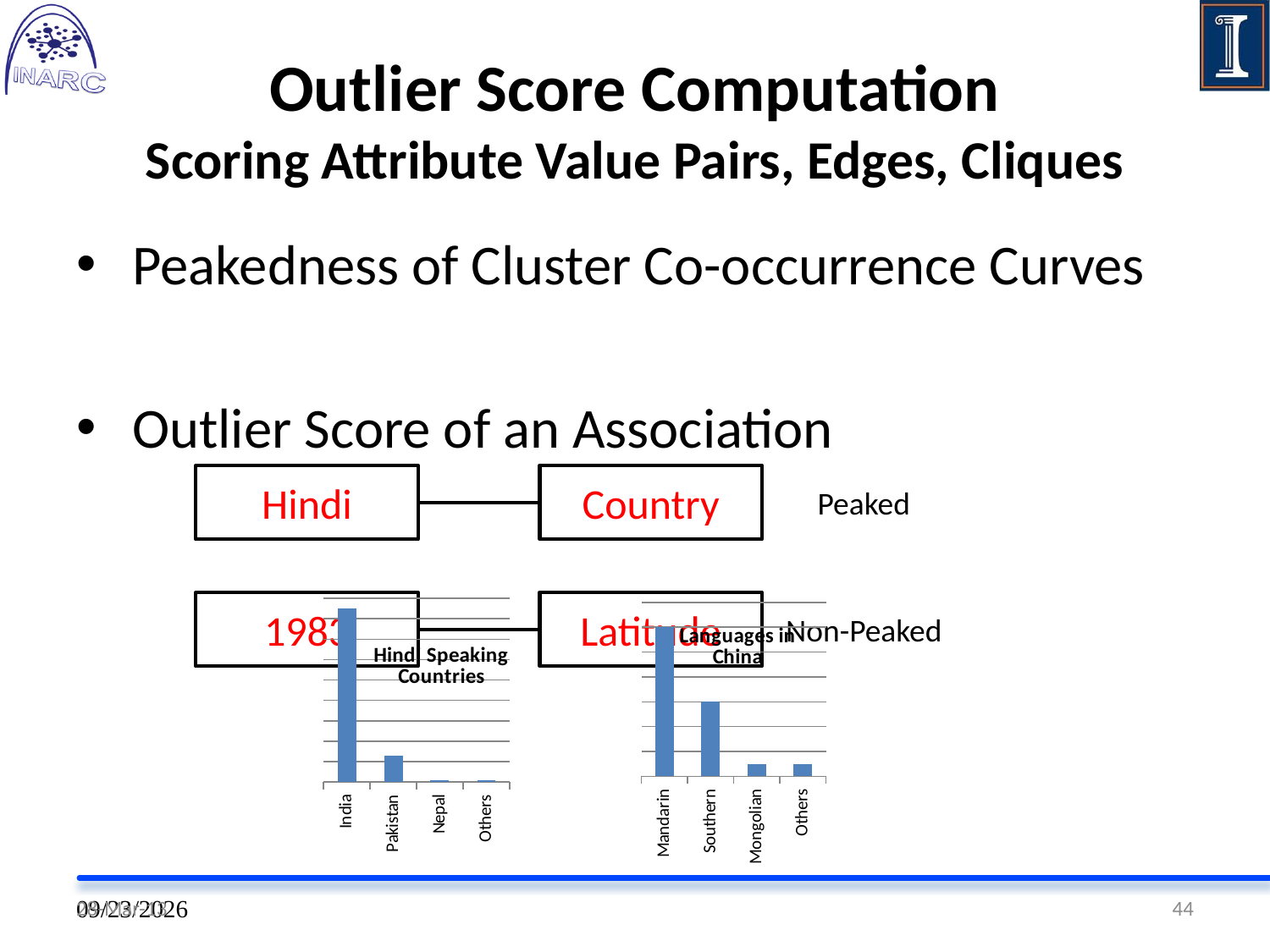
In the Hindi Speaking Countries chart, which country has the highest bar? India What kind of chart is the Languages in China chart? Bar chart In the Languages in China chart, which is larger, the bar for Mandarin or the bar for Southern? Mandarin What is the title of the left chart on the slide? Hindi Speaking Countries What kind of chart is the Hindi Speaking Countries chart? Bar chart In the Languages in China chart, which language has the highest bar? Mandarin What are the category labels on the x axis of the Languages in China chart? Mandarin, Southern, Mongolian, Others How many categories are shown in the Hindi Speaking Countries chart? 4 How many categories are shown in the Languages in China chart? 4 In the Hindi Speaking Countries chart, which is larger, the bar for India or the bar for Pakistan? India In the Languages in China chart, which is larger, the bar for Southern or the bar for Mongolian? Southern